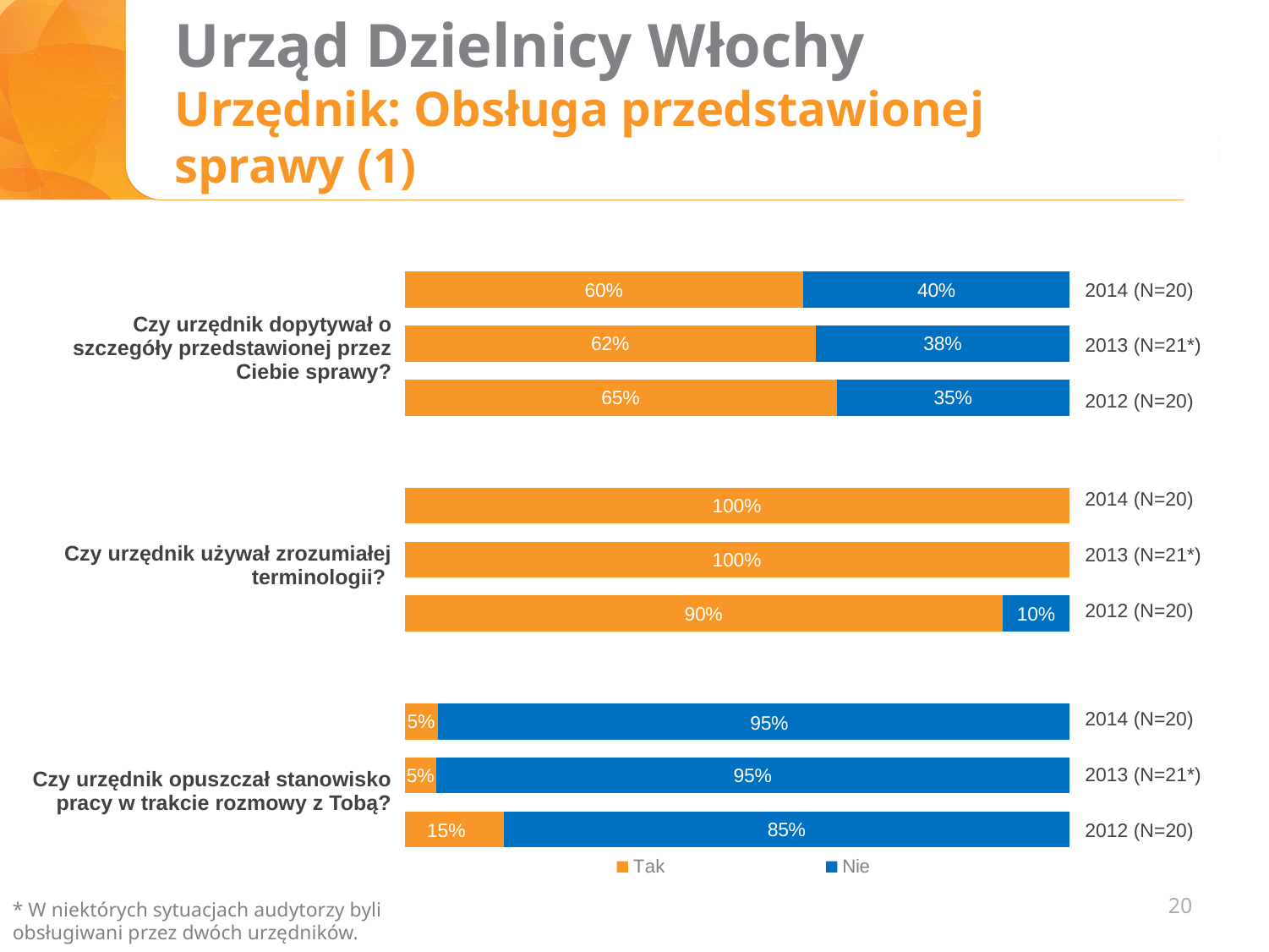
Which colour represents the "Nie" answers in the chart? Blue What type of chart is shown on the slide? Stacked bar chart What percentage answered "Nie" in 2013 for the question "Czy urzędnik dopytywał o szczegóły przedstawionej przez Ciebie sprawy?"? 38% For the question "Czy urzędnik dopytywał o szczegóły przedstawionej przez Ciebie sprawy?", which year had the highest "Tak" share? 2012 How many series does the legend list? 2 For the question "Czy urzędnik używał zrozumiałej terminologii?", is the "Tak" share in 2012 larger or smaller than in 2014? smaller How many bars are shown in the chart in total? 9 For the question "Czy urzędnik opuszczał stanowisko pracy w trakcie rozmowy z Tobą?", which year had the lowest "Nie" share? 2012 What percentage answered "Nie" in 2012 for the question "Czy urzędnik używał zrozumiałej terminologii?"? 10% What percentage answered "Tak" in 2012 for the question "Czy urzędnik opuszczał stanowisko pracy w trakcie rozmowy z Tobą?"? 15% What percentage answered "Tak" in 2014 for the question "Czy urzędnik dopytywał o szczegóły przedstawionej przez Ciebie sprawy?"? 60% What is the difference in percentage points between the "Tak" share in 2012 and in 2014 for the question "Czy urzędnik dopytywał o szczegóły przedstawionej przez Ciebie sprawy?"? 5 percentage points